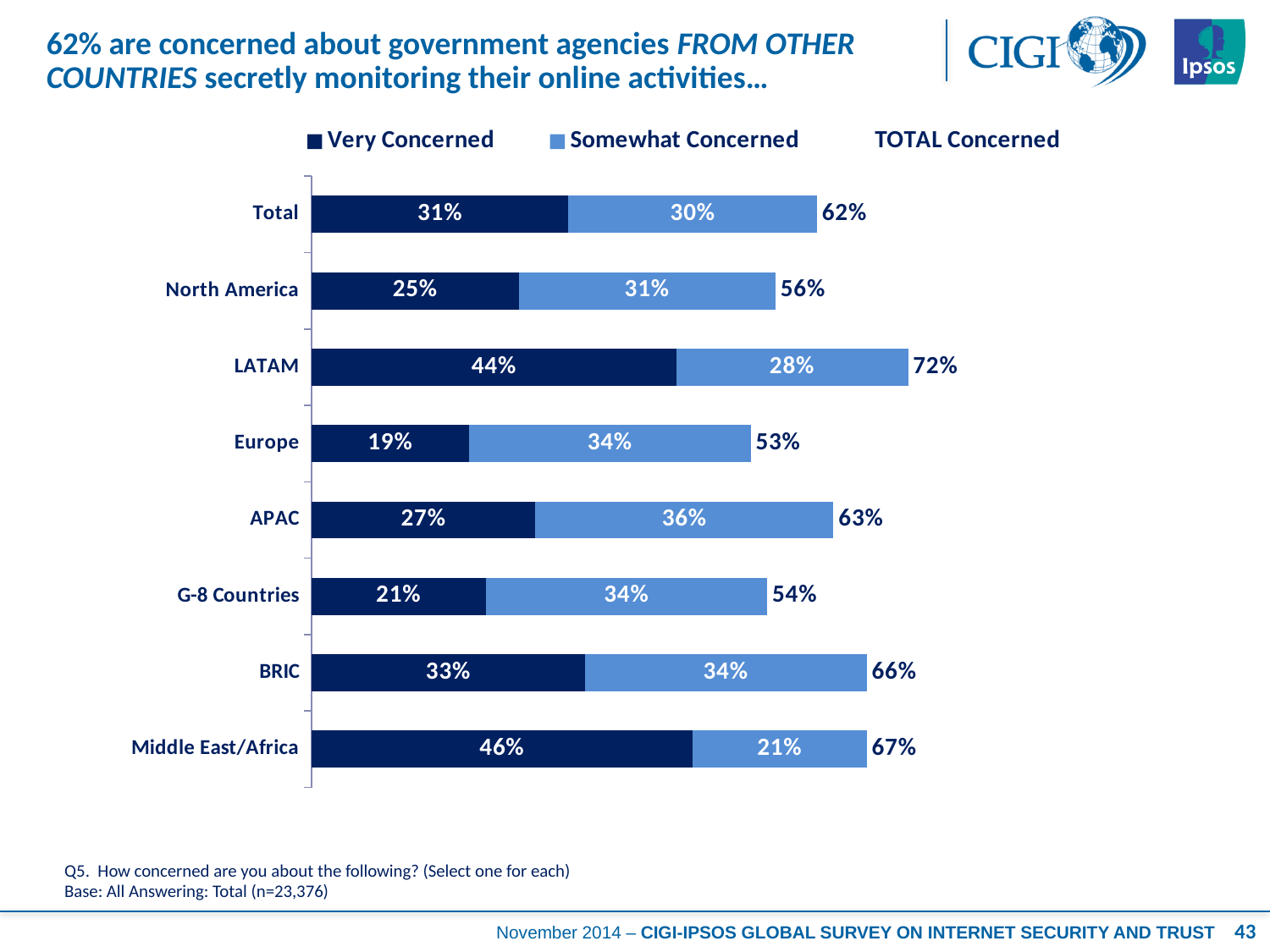
What is the Somewhat Concerned value for APAC? 36% What percentage of respondents in LATAM are Very Concerned? 44% Which region has the highest Very Concerned percentage? Middle East/Africa What is the TOTAL Concerned value for Middle East/Africa? 67% Which is larger, the TOTAL Concerned value for BRIC or for G-8 Countries? BRIC What is the difference between the Very Concerned values for LATAM and Europe? 25% How many series does the legend list with a colour swatch? 2 What kind of chart is shown on the slide? Stacked bar chart Which colour represents Very Concerned in the chart? Dark blue How many regions or groups are shown on the chart, including Total? 8 Which region has the lowest TOTAL Concerned percentage? Europe What is the TOTAL Concerned value for North America? 56%